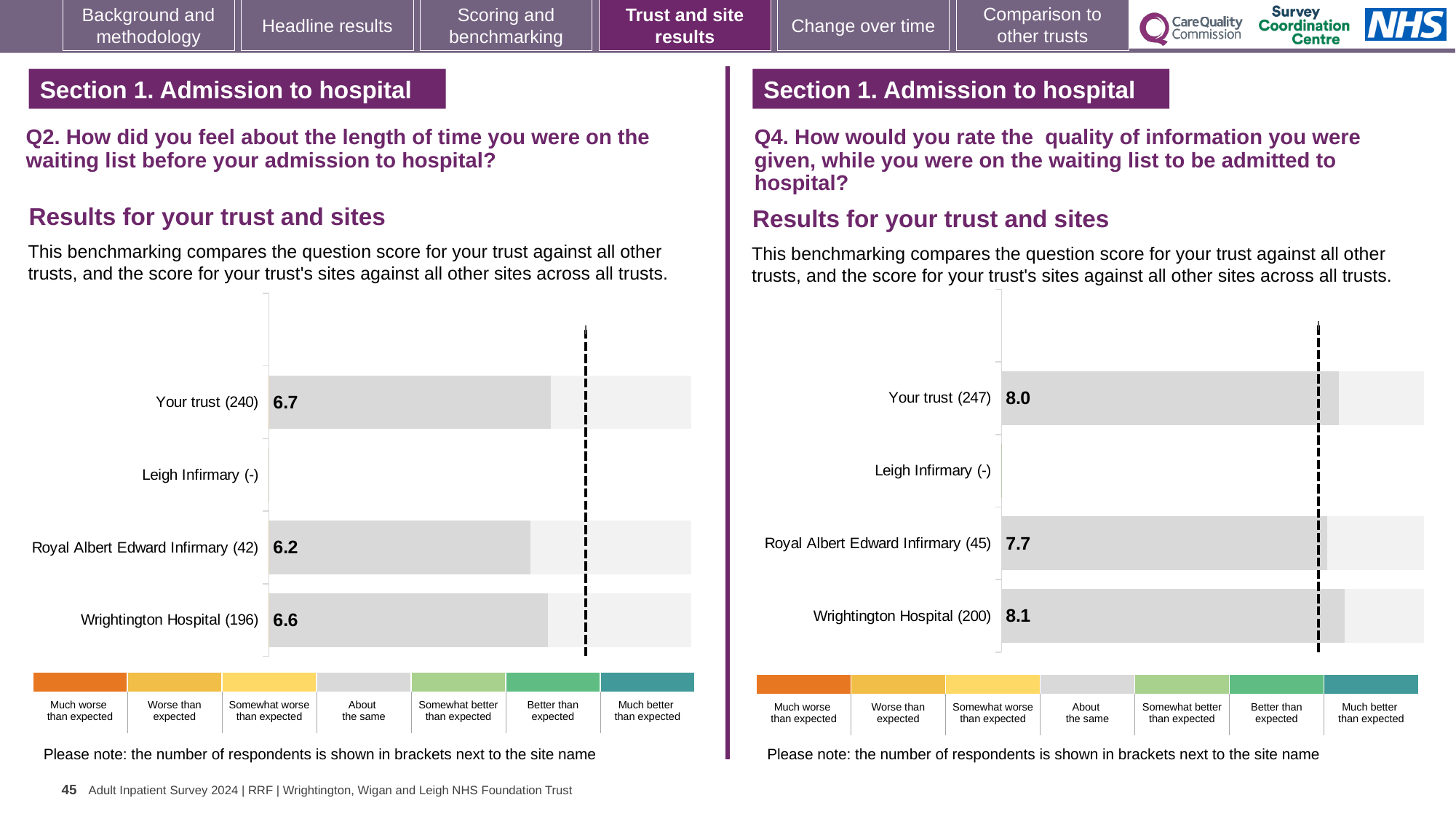
In the Q4 chart on the right, which has the higher score, Wrightington Hospital or Royal Albert Edward Infirmary? Wrightington Hospital In the Q2 chart on the left, what is the score for Wrightington Hospital? 6.6 In the Q4 chart on the right, what is the score for Wrightington Hospital? 8.1 In the Q2 chart on the left, what is the score for Your trust? 6.7 In the Q4 chart on the right, what is the difference between the scores for Wrightington Hospital and Royal Albert Edward Infirmary? 0.4 In the Q2 chart on the left, how many respondents are shown in brackets for Your trust? 240 In the Q2 chart on the left, which site has the lowest score? Royal Albert Edward Infirmary In the Q4 chart on the right, what is the score for Royal Albert Edward Infirmary? 7.7 What kind of chart is used for the Q2 results on the left? Bar chart In the Q2 chart on the left, what is the score for Royal Albert Edward Infirmary? 6.2 In the Q4 chart on the right, what is the score for Your trust? 8.0 In the Q2 chart on the left, what is the difference between the scores for Your trust and Royal Albert Edward Infirmary? 0.5